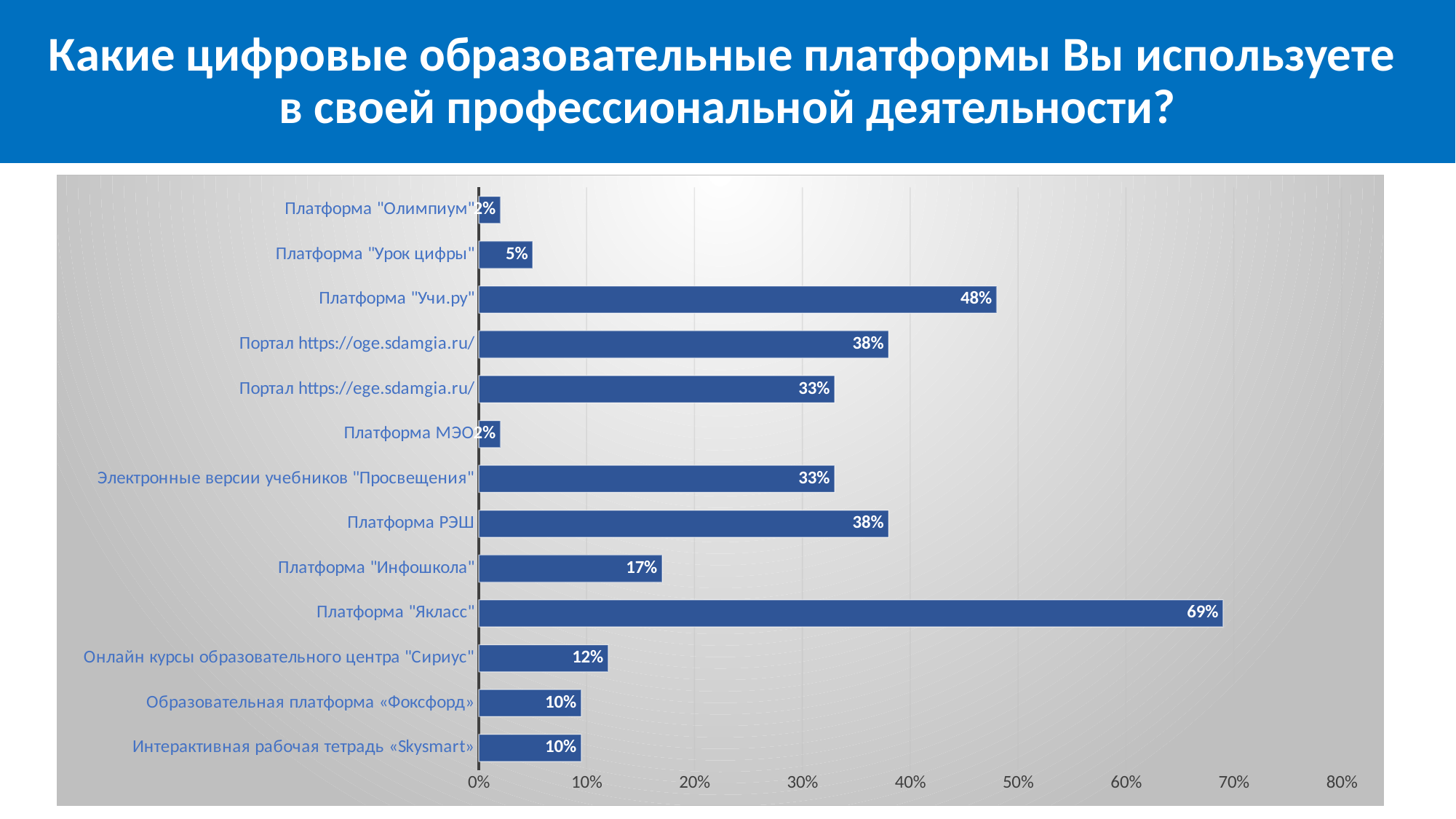
What is the value for Платформа "Якласс"? 69% How many platforms (categories) are shown in the chart? 13 Which is larger: the value for Платформа "Учи.ру" or the value for Платформа РЭШ? Платформа "Учи.ру" Which platform has the highest value in the chart? Платформа "Якласс" What is the value for Онлайн курсы образовательного центра "Сириус"? 12% What is the highest value shown on the horizontal axis of the chart? 80% What is the difference between the values for Платформа "Якласс" and Платформа "Учи.ру"? 21% What is the value for Платформа "Учи.ру"? 48% What is the value for Платформа "Урок цифры"? 5% Is the value for Портал https://oge.sdamgia.ru/ greater or less than 30%? greater What is the value for Платформа "Инфошкола"? 17% What type of chart is shown on the slide? bar chart